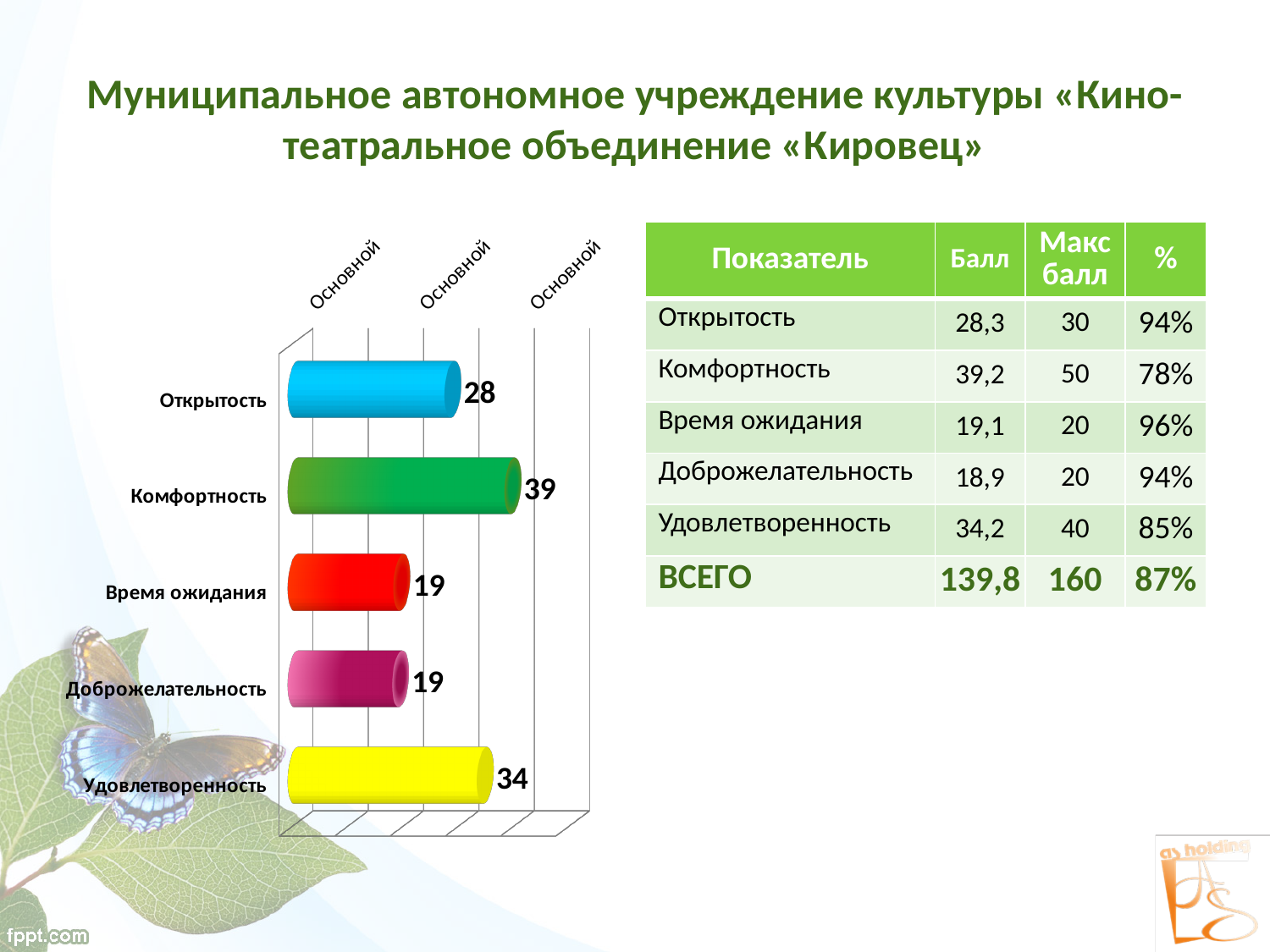
What is the difference between the values for Комфортность and Открытость on the bar chart? 11 What value is shown for Комфортность on the bar chart? 39 What value is shown for Время ожидания on the bar chart? 19 What is the difference between the values for Удовлетворенность and Доброжелательность on the bar chart? 15 How many categories are plotted on the bar chart? 5 What value is shown for Удовлетворенность on the bar chart? 34 What value is shown for Открытость on the bar chart? 28 Which category has the highest value on the bar chart? Комфортность What kind of chart is shown on the slide? Bar chart Which is larger on the bar chart, the value for Открытость or the value for Удовлетворенность? Удовлетворенность What colour is the bar for Открытость on the chart? Blue What colour is the bar for Удовлетворенность on the chart? Yellow